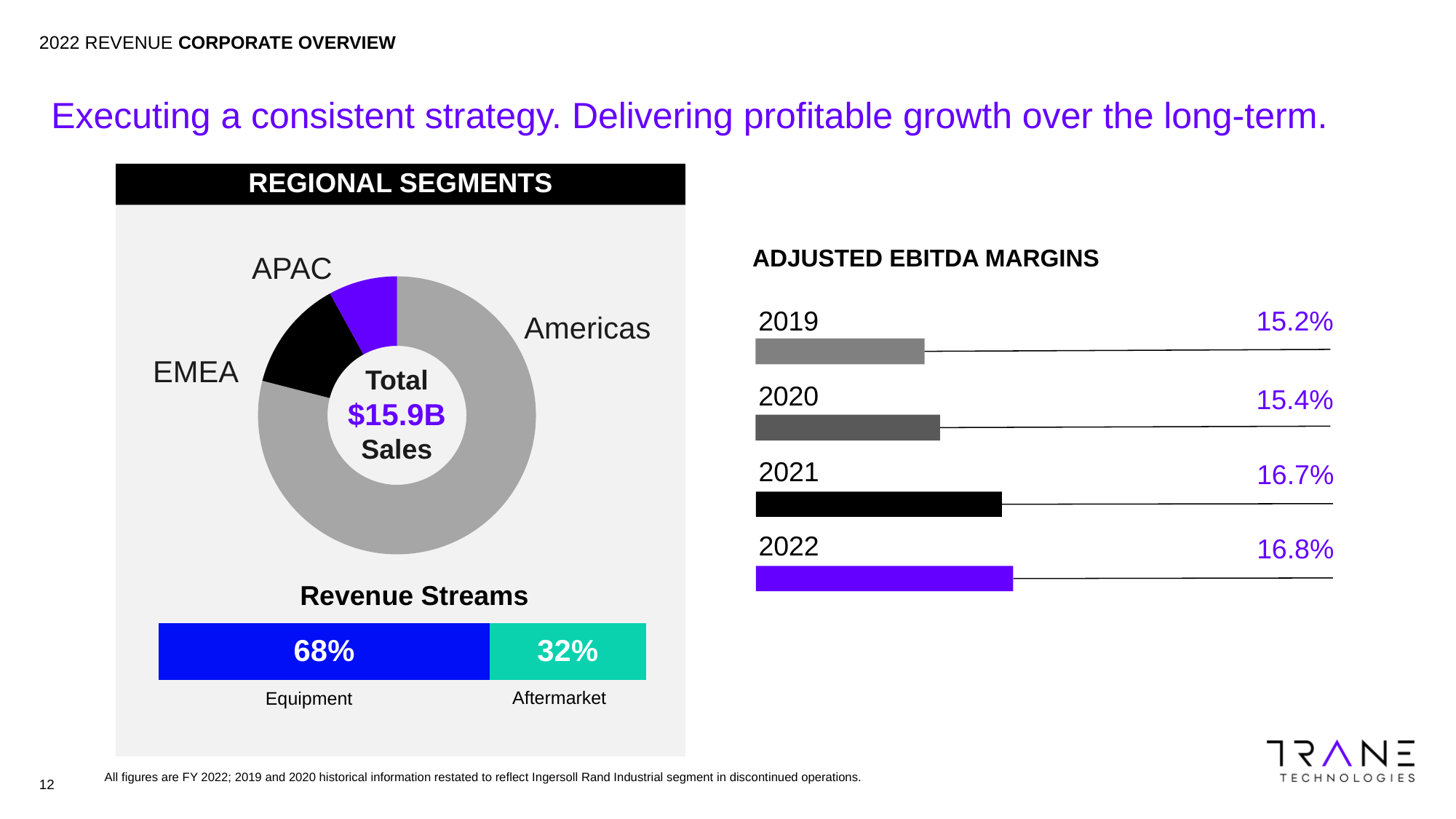
How many years are shown in the Adjusted EBITDA Margins chart? 4 In the Adjusted EBITDA Margins chart, is the 2020 margin larger or smaller than the 2021 margin? smaller What kind of chart is used for the Regional Segments? donut (pie) chart In the Adjusted EBITDA Margins chart, what was the margin in 2022? 16.8% In the Adjusted EBITDA Margins chart, which year has the highest margin? 2022 In the Adjusted EBITDA Margins chart, what was the margin in 2019? 15.2% In the Adjusted EBITDA Margins chart, what is the difference between the 2021 and 2020 margins? 1.3% In the Adjusted EBITDA Margins chart, which year has the lowest margin? 2019 In the Revenue Streams bar, what share is Equipment? 68% In the Regional Segments chart, which region has the largest share of sales? Americas Do the values in the Adjusted EBITDA Margins chart rise or fall from 2019 to 2022? rise What total sales figure is shown in the centre of the Regional Segments chart? $15.9B